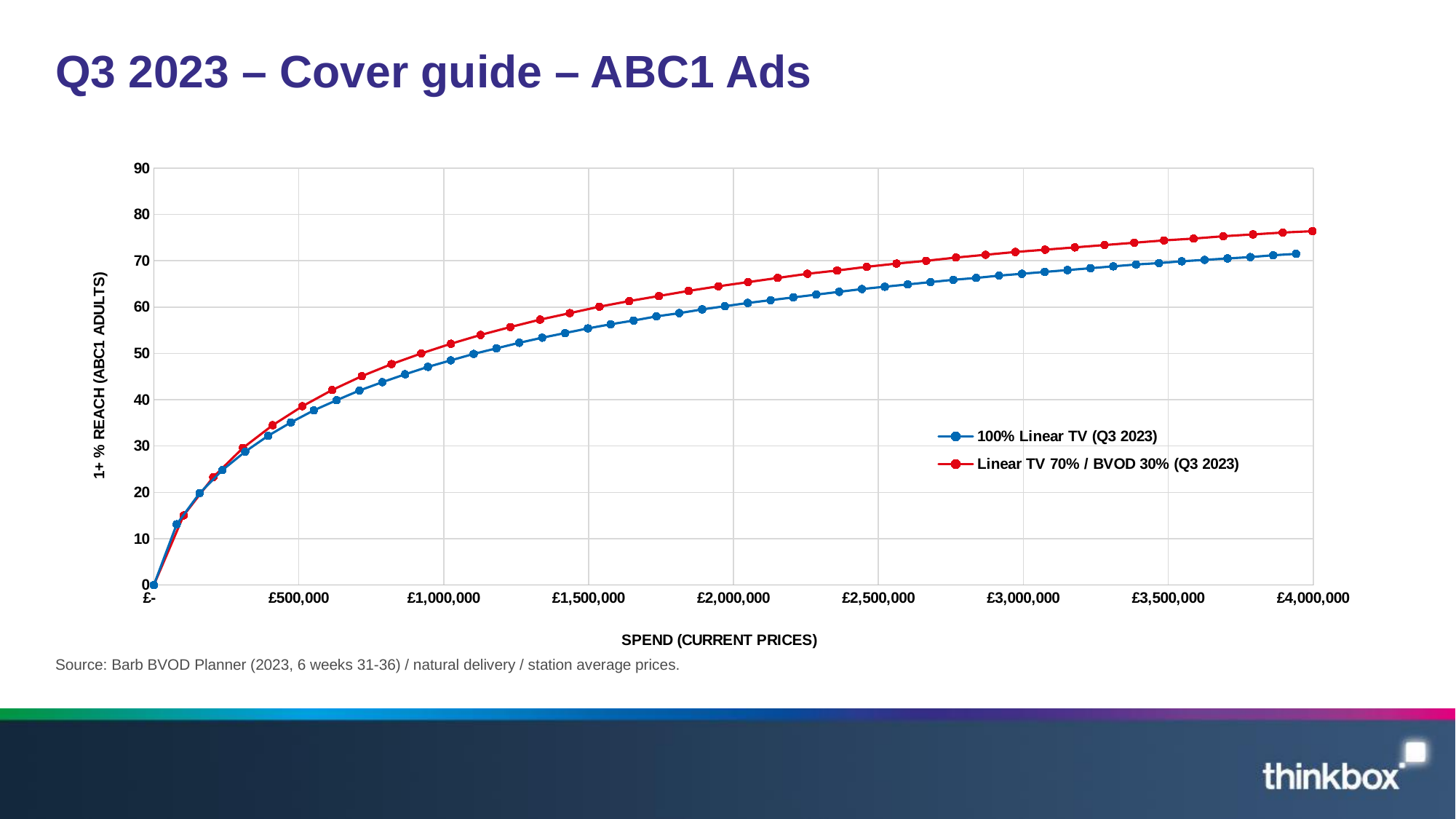
At a spend of £4,000,000, which series has the higher 1+ % reach: 100% Linear TV (Q3 2023) or Linear TV 70% / BVOD 30% (Q3 2023)? Linear TV 70% / BVOD 30% (Q3 2023) Do the values for 100% Linear TV (Q3 2023) rise or fall as spend increases along the x axis? rise Do the values for Linear TV 70% / BVOD 30% (Q3 2023) rise or fall as spend increases along the x axis? rise What colour is the line for Linear TV 70% / BVOD 30% (Q3 2023)? red How many series does the legend list? 2 Is the 1+ % reach for 100% Linear TV (Q3 2023) at a spend of £500,000 greater or less than 40? less At a spend of £2,000,000, which series has the lower 1+ % reach: 100% Linear TV (Q3 2023) or Linear TV 70% / BVOD 30% (Q3 2023)? 100% Linear TV (Q3 2023) Is the 1+ % reach for Linear TV 70% / BVOD 30% (Q3 2023) at a spend of £4,000,000 greater or less than 70? greater What is the title of the x axis of the chart? SPEND (CURRENT PRICES) Is the 1+ % reach for 100% Linear TV (Q3 2023) at a spend of £1,000,000 greater or less than 40? greater What kind of chart is shown on the slide? line chart